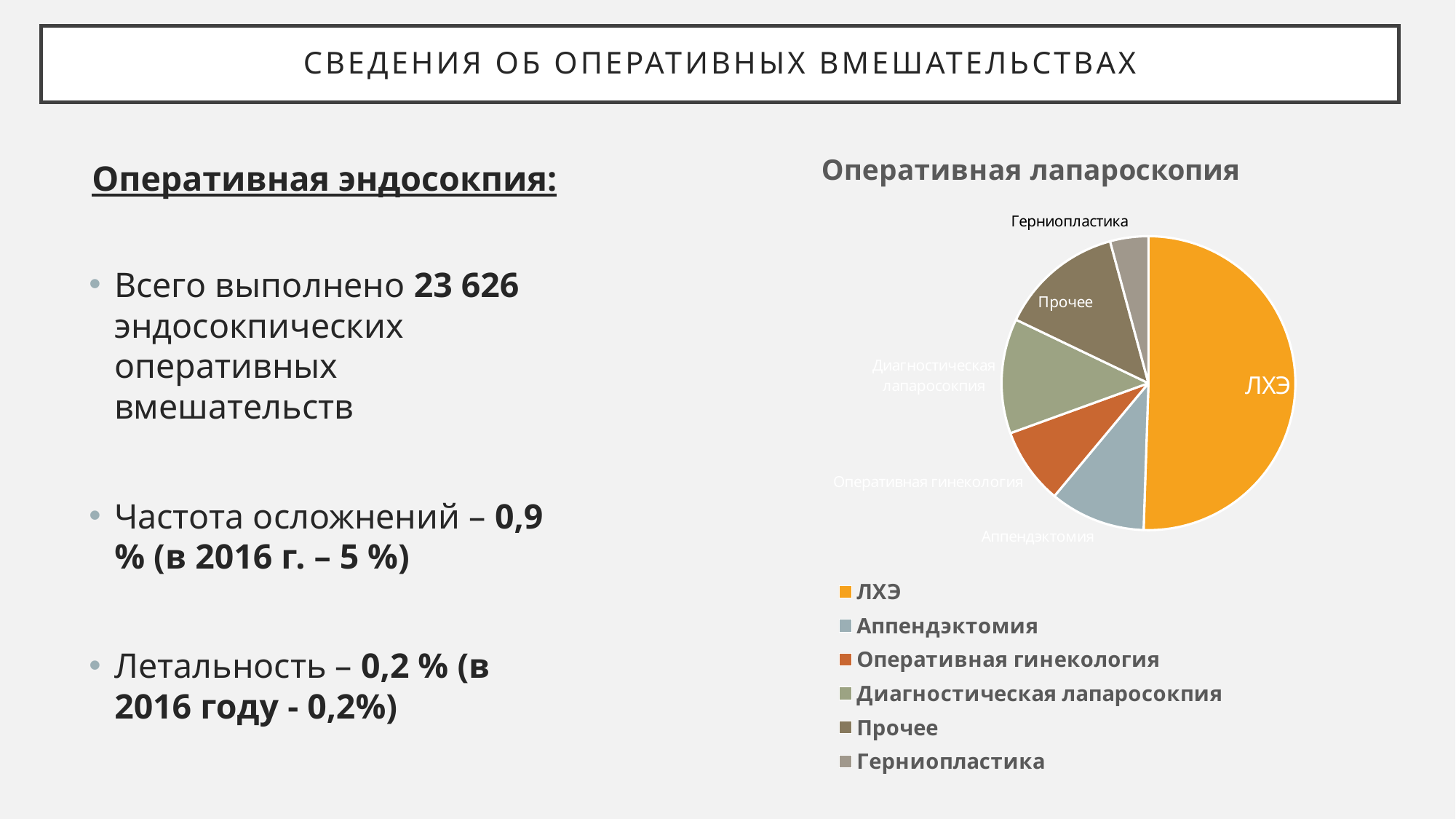
How many entries does the chart legend list? 6 Which slice is larger, Прочее or Герниопластика? Прочее What colour is the ЛХЭ slice in the pie chart? orange How many slices does the pie chart have? 6 Which category has the smallest slice of the pie? Герниопластика Which category has the largest slice of the pie? ЛХЭ Which slice is larger, ЛХЭ or Прочее? ЛХЭ What is the title of the chart? Оперативная лапароскопия Which slice is larger, Аппендэктомия or Герниопластика? Аппендэктомия What kind of chart is shown on the slide? pie chart